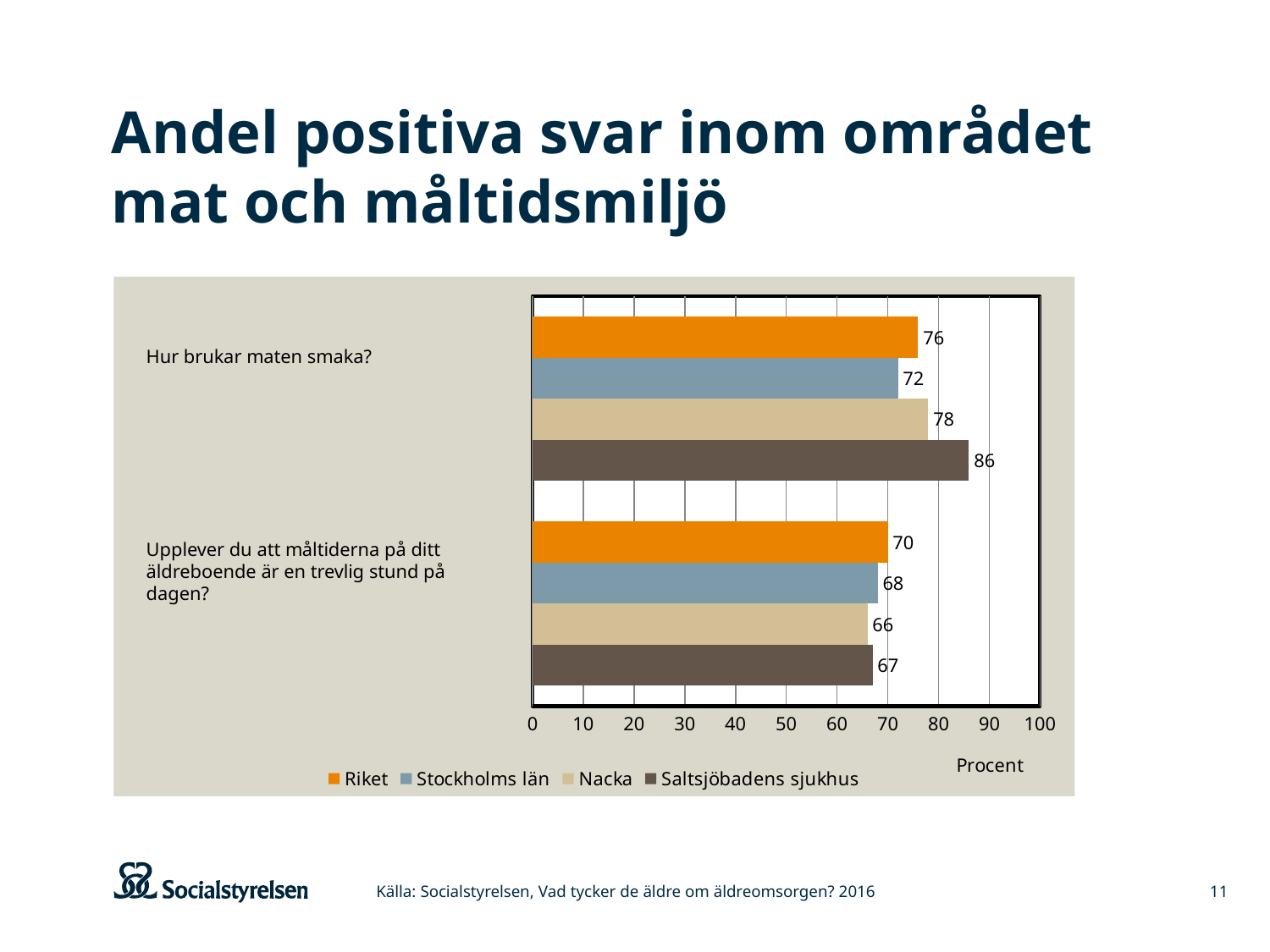
What is the label on the horizontal axis of the chart? Procent Is the value for Saltsjöbadens sjukhus for "Hur brukar maten smaka?" greater or less than 80? greater Which series has the highest value for the question "Hur brukar maten smaka?"? Saltsjöbadens sjukhus What value is shown for Riket for the question "Upplever du att måltiderna på ditt äldreboende är en trevlig stund på dagen?"? 70 What value is shown for Nacka for the question "Hur brukar maten smaka?"? 78 Which is larger for "Upplever du att måltiderna på ditt äldreboende är en trevlig stund på dagen?": Riket or Stockholms län? Riket What kind of chart is shown on the slide? Bar chart How many series does the legend list? 4 What value is shown for Saltsjöbadens sjukhus for the question "Hur brukar maten smaka?"? 86 What is the difference between the Saltsjöbadens sjukhus value and the Stockholms län value for "Hur brukar maten smaka?"? 14 Which series has the lowest value for the question "Upplever du att måltiderna på ditt äldreboende är en trevlig stund på dagen?"? Nacka How many questions (categories) are shown on the chart? 2